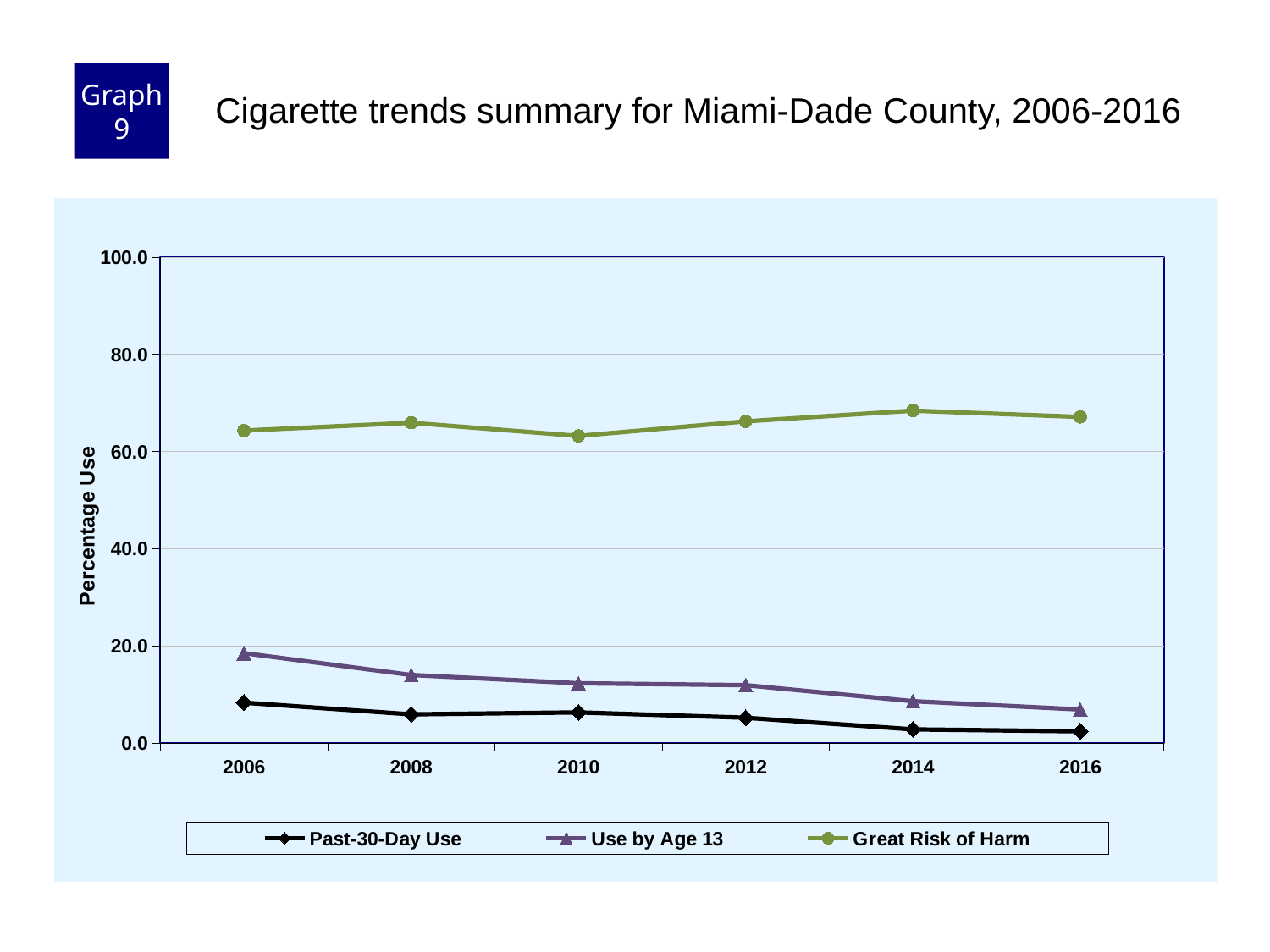
How many years are plotted along the x axis? 6 How many series does the legend list? 3 Is the value for Past-30-Day Use in 2016 greater or less than 20? less Is the value for Use by Age 13 in 2006 greater or less than 20? less In which year is Use by Age 13 highest? 2006 In which year is Past-30-Day Use highest? 2006 What is the label on the y axis? Percentage Use In 2016, which is larger: Great Risk of Harm or Use by Age 13? Great Risk of Harm Is the value for Great Risk of Harm in 2014 greater or less than 80? less What kind of chart is shown on the slide? line chart Does Use by Age 13 rise or fall from 2006 to 2016? fall